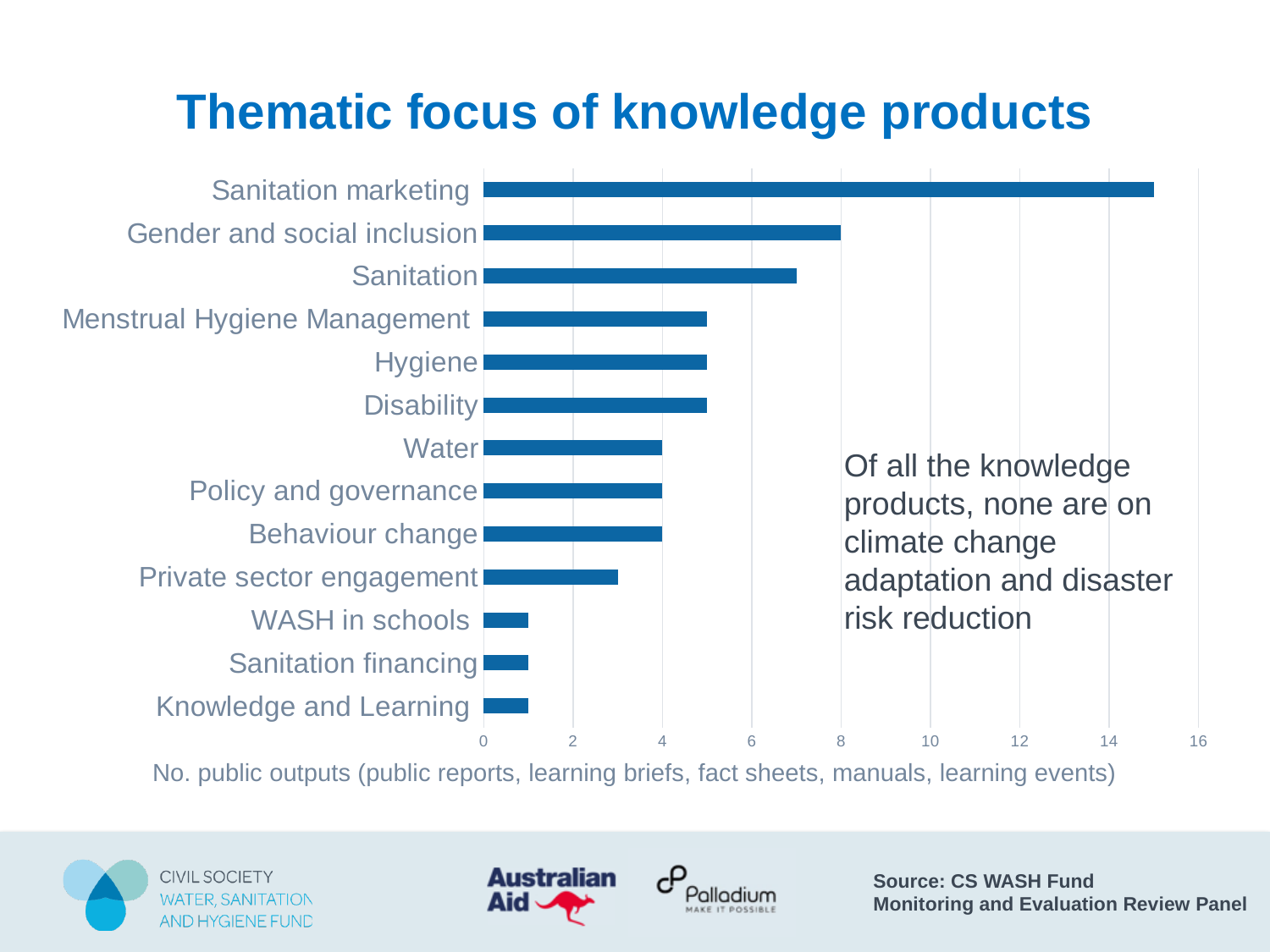
What is the value for Behaviour change? 4 What type of chart is shown on the slide? Bar chart What is the difference between the values for Gender and social inclusion and Water? 4 Which has a larger value, Sanitation or Gender and social inclusion? Gender and social inclusion What is the title of the chart? Thematic focus of knowledge products How many thematic categories are plotted in the chart? 13 What is the value for Gender and social inclusion? 8 What is the value for Policy and governance? 4 Is the value for Private sector engagement greater or less than 4? less Is the value for WASH in schools greater or less than 2? less Is the value for Sanitation marketing greater or less than 14? greater Which thematic category has the highest number of public outputs? Sanitation marketing